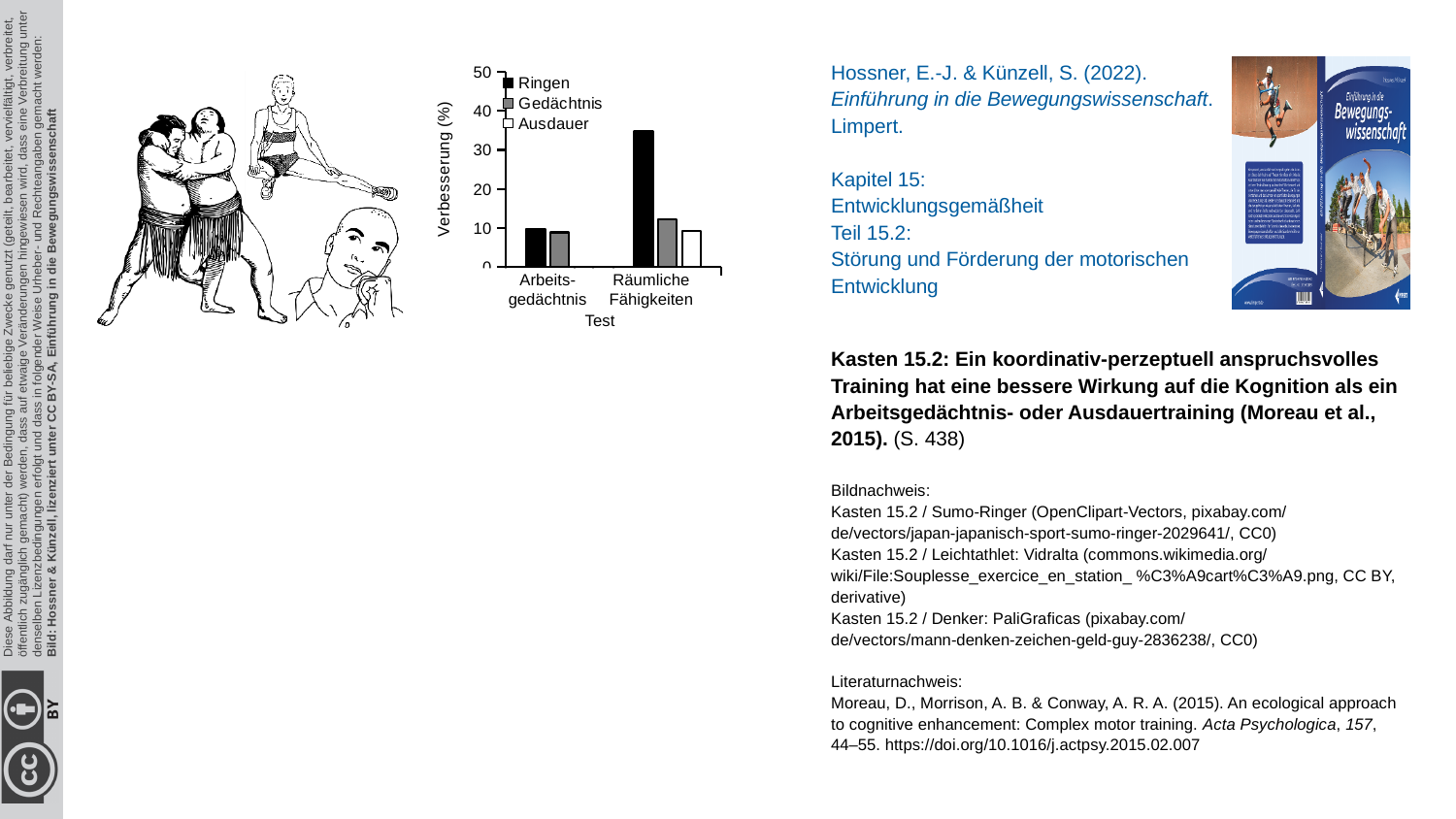
What is the label of the y axis of the chart? Verbesserung (%) How many series does the chart legend list? 3 Which series has the lowest value for Räumliche Fähigkeiten? Ausdauer Is the value for Ringen in Arbeitsgedächtnis greater or less than 20? less How many categories are shown on the x axis of the chart? 2 Is the value for Gedächtnis in Räumliche Fähigkeiten greater or less than 20? less Which series has the highest value for Räumliche Fähigkeiten? Ringen Which is larger for Ringen: Arbeitsgedächtnis or Räumliche Fähigkeiten? Räumliche Fähigkeiten Which is larger for Räumliche Fähigkeiten: Ringen or Ausdauer? Ringen What kind of chart is shown on the slide? bar chart Is the value for Ringen in Räumliche Fähigkeiten greater or less than 30? greater What is the label of the x axis of the chart? Test